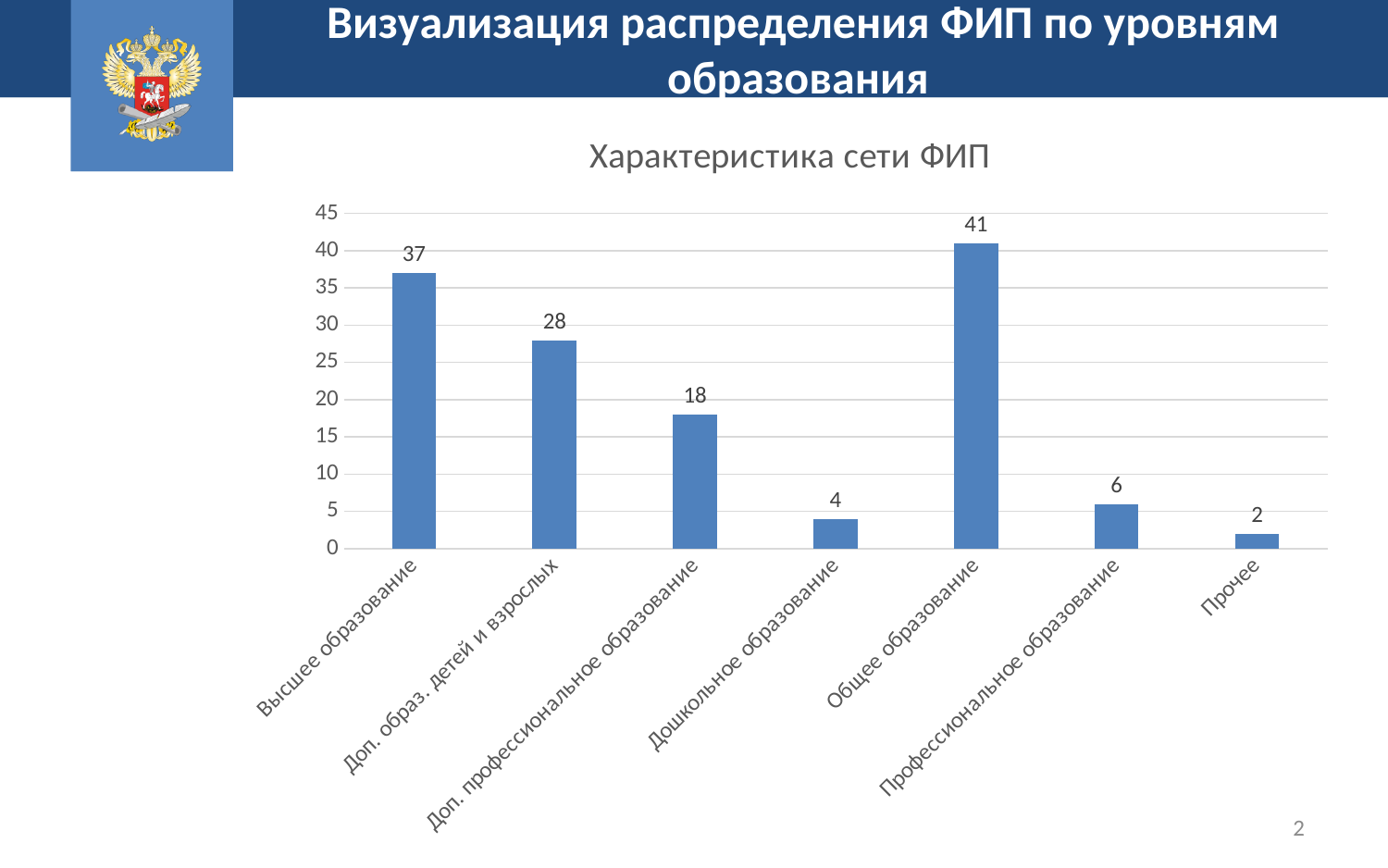
What is the value for Профессиональное образование? 6 What is the title of the chart? Характеристика сети ФИП What is the value for Дошкольное образование? 4 What is the value for Высшее образование? 37 Which category has the lowest value? Прочее How many categories are shown on the x axis? 7 What kind of chart is shown on the slide? bar chart Which is larger, the value for Доп. образ. детей и взрослых or the value for Доп. профессиональное образование? Доп. образ. детей и взрослых Is the value for Доп. профессиональное образование greater or less than 20? less What is the difference between the values for Доп. образ. детей и взрослых and Доп. профессиональное образование? 10 What is the difference between the values for Общее образование and Высшее образование? 4 Which category has the highest value? Общее образование